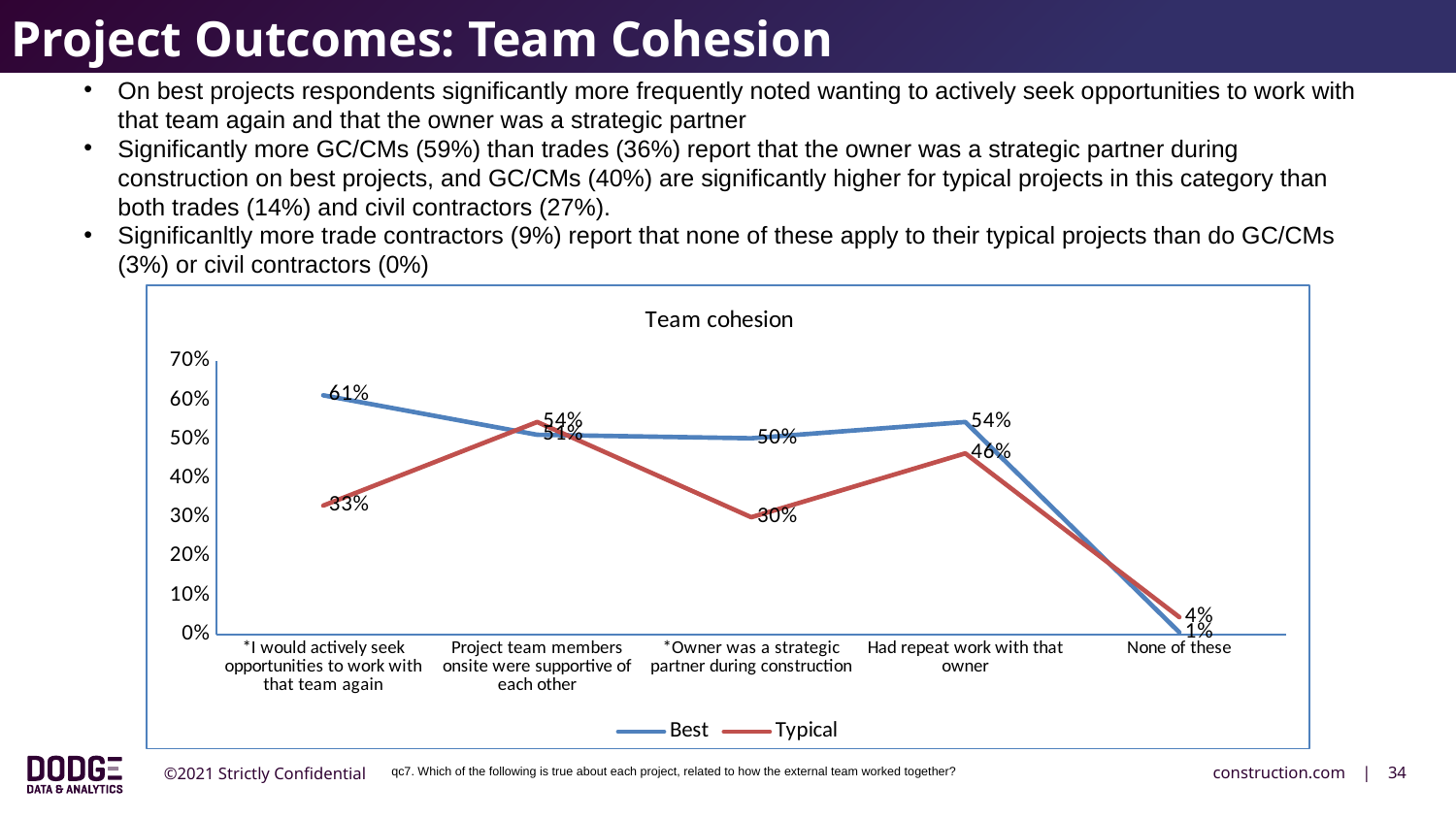
For "Owner was a strategic partner during construction", which series has the larger value, Best or Typical? Best What is the Typical value for "Owner was a strategic partner during construction"? 30% What is the Best value for "I would actively seek opportunities to work with that team again"? 61% What is the difference between the Best and Typical values for "I would actively seek opportunities to work with that team again"? 28% What is the title of the chart? Team cohesion Is the Best value for "Had repeat work with that owner" greater or less than 50%? greater Which category has the highest Best value? I would actively seek opportunities to work with that team again How many categories are shown on the x axis of the chart? 5 What type of chart is shown on the slide? line chart How many series does the chart legend list? 2 What is the Typical value for "Had repeat work with that owner"? 46% Which category has the lowest Typical value? None of these